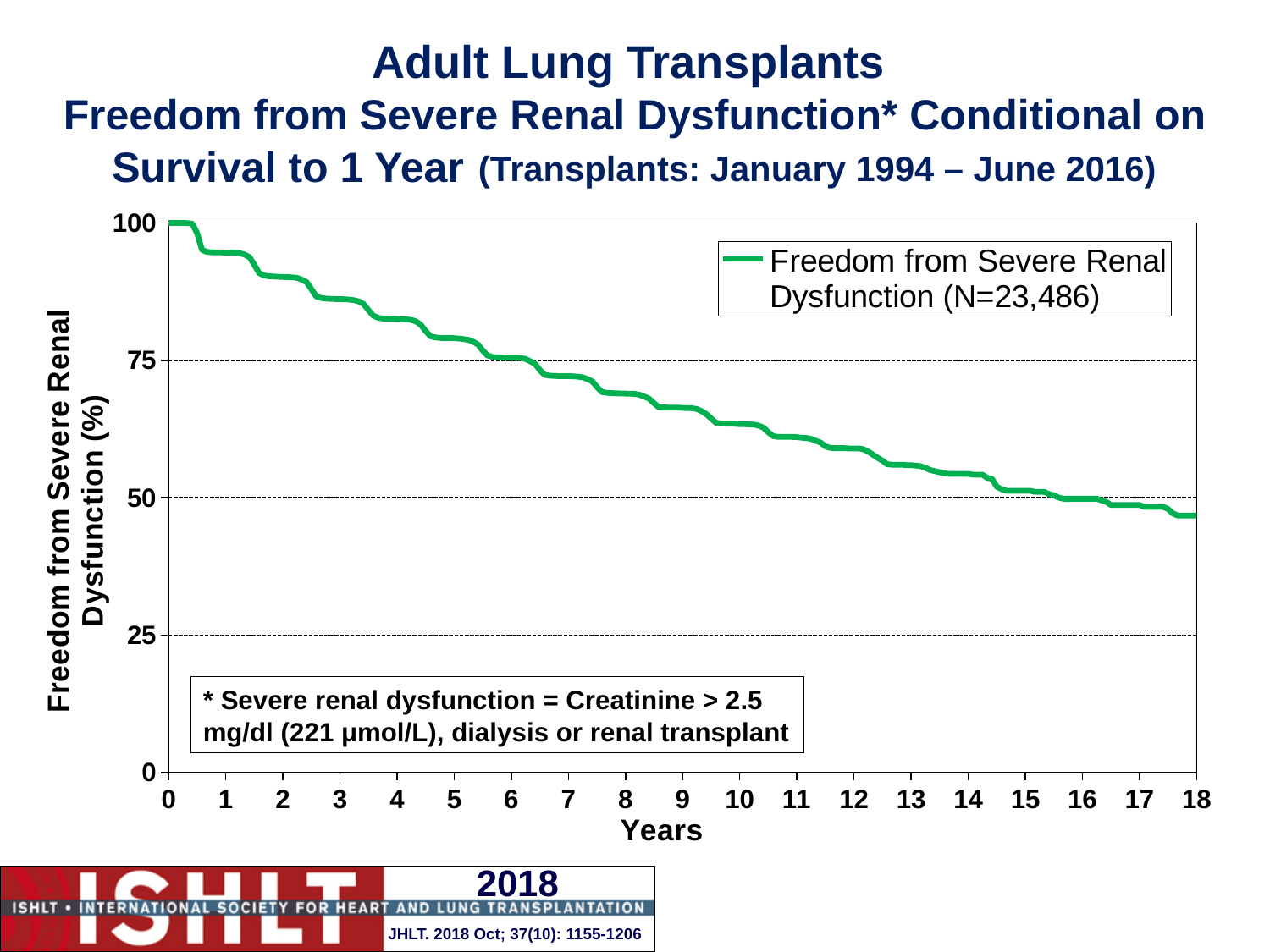
Which year has a higher freedom from severe renal dysfunction, year 2 or year 12? Year 2 What is the N value given in the legend entry? N=23,486 What is the value of freedom from severe renal dysfunction at year 0? 100 Does the freedom from severe renal dysfunction rise or fall as years increase? Fall What is the label of the x axis? Years How many series does the legend list? 1 Is the value for freedom from severe renal dysfunction at year 3 greater or less than 75? greater Is the value for freedom from severe renal dysfunction at year 5 greater or less than 75? greater Is the value for freedom from severe renal dysfunction at year 18 greater or less than 50? less What kind of chart is shown on the slide? Line chart